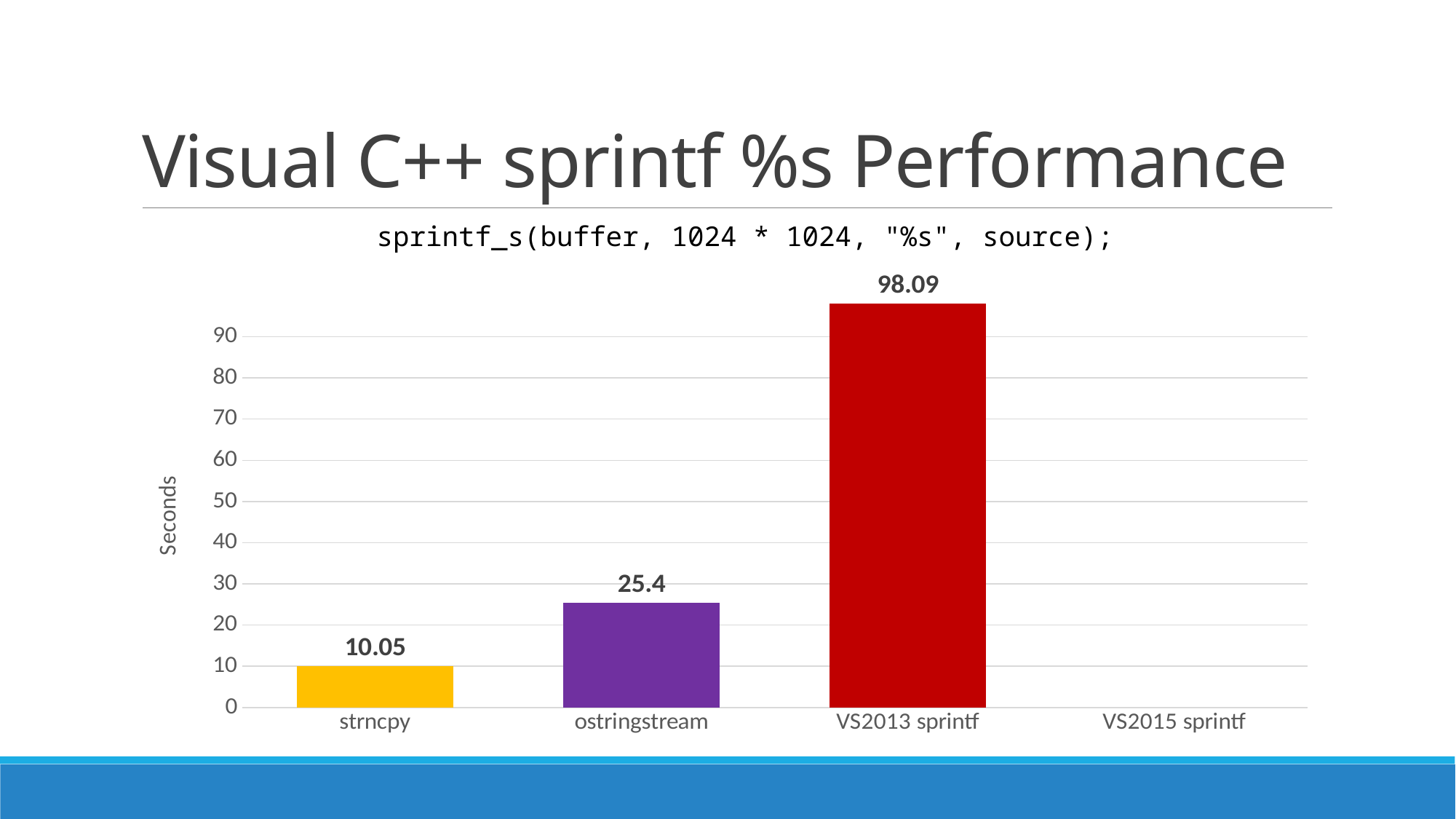
How many categories are labelled on the x axis? 4 Is the value for ostringstream greater or less than 30? less Is the value for VS2013 sprintf greater or less than 90? greater What kind of chart is shown? bar chart Which is larger, the value for ostringstream or the value for strncpy? ostringstream What is the difference between the values for VS2013 sprintf and ostringstream? 72.69 What is the value for strncpy? 10.05 What is the label on the y axis? Seconds What is the value for ostringstream? 25.4 What is the difference between the values for ostringstream and strncpy? 15.35 What is the value for VS2013 sprintf? 98.09 Which category has the highest value? VS2013 sprintf